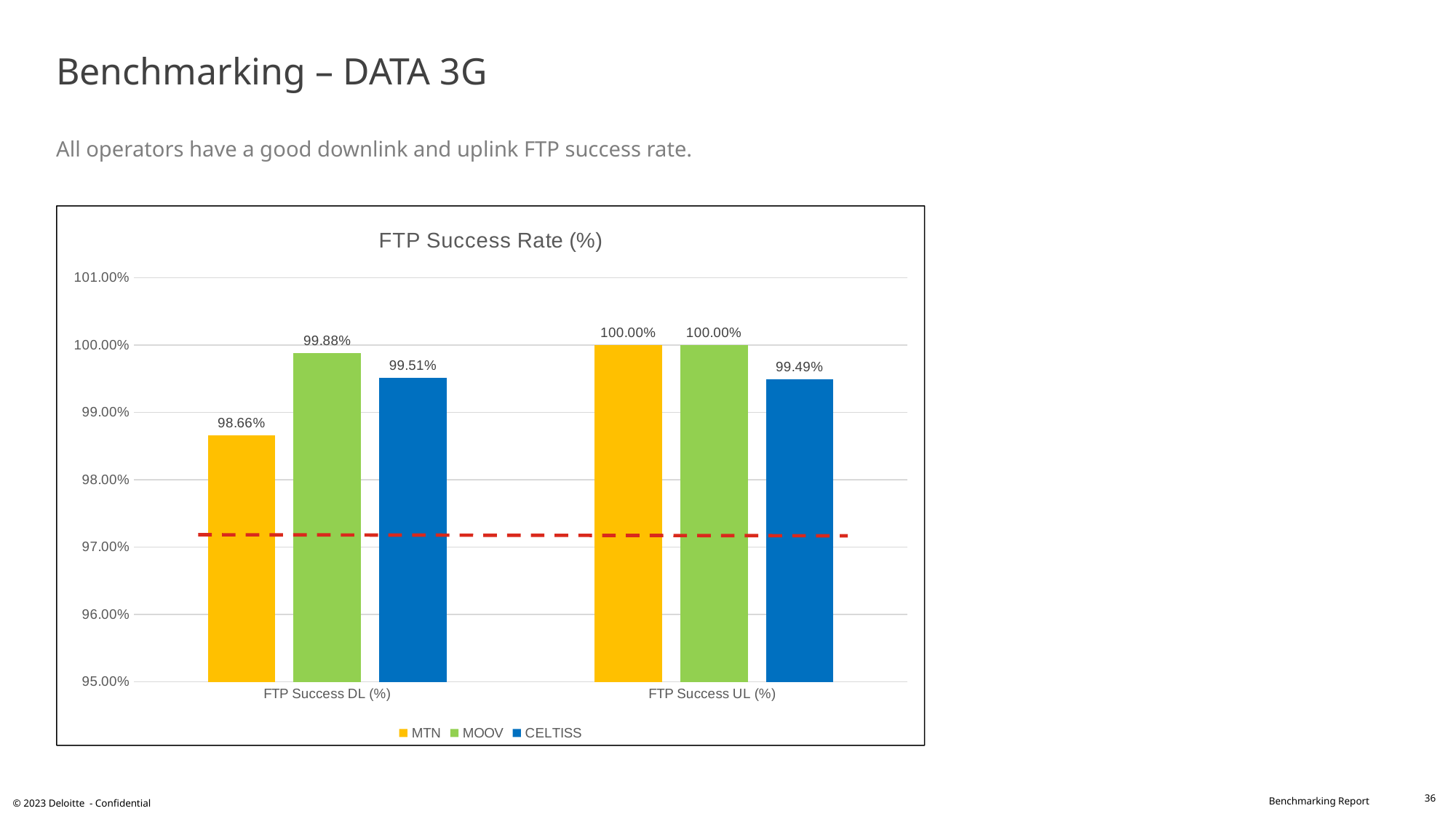
What is the difference between MOOV's and MTN's FTP Success DL (%) values? 1.22% What kind of chart is shown? Bar chart Which operator has the lowest FTP Success DL (%)? MTN Which is larger: CELTISS's FTP Success DL (%) or CELTISS's FTP Success UL (%)? FTP Success DL (%) Which operator has the lowest FTP Success UL (%)? CELTISS What is the FTP Success DL (%) value for MOOV? 99.88% What is the FTP Success UL (%) value for CELTISS? 99.49% How many categories are shown on the x axis? 2 What is the title of the chart? FTP Success Rate (%) How many series does the legend list? 3 Which operator has the highest FTP Success DL (%)? MOOV What is the FTP Success DL (%) value for MTN? 98.66%